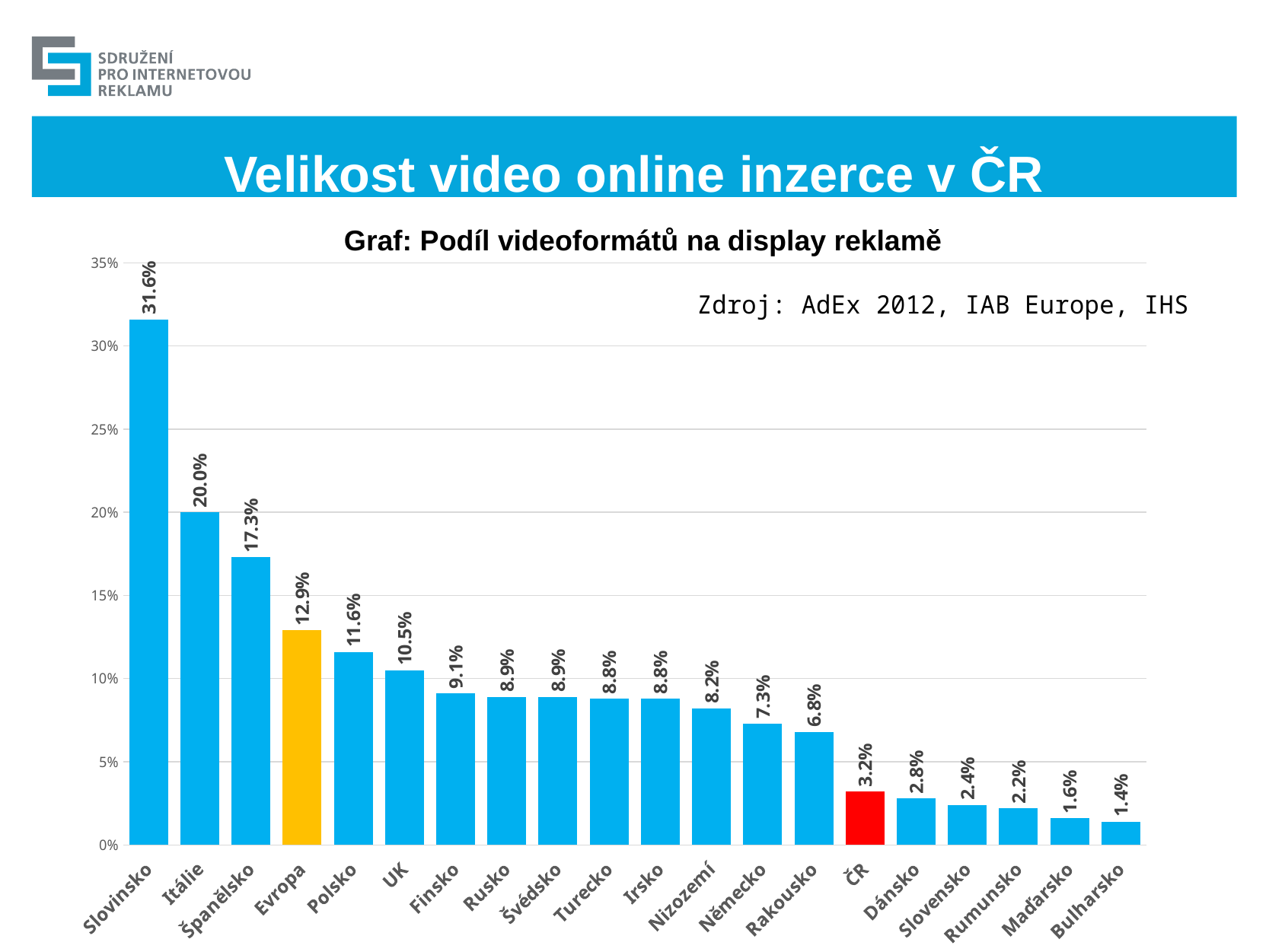
What is the difference between the values for Evropa and ČR? 9.7% What is the value for ČR? 3.2% Which is larger, the value for Německo or the value for Rakousko? Německo What is the value for Evropa? 12.9% How many categories are shown on the x axis? 20 What is the difference between the values for Slovinsko and Itálie? 11.6% Which category has the highest value? Slovinsko What kind of chart is shown on the slide? bar chart What is the value for Polsko? 11.6% Is the value for Španělsko greater or less than 15%? greater What is the title of the chart? Graf: Podíl videoformátů na display reklamě Which category has the lowest value? Bulharsko